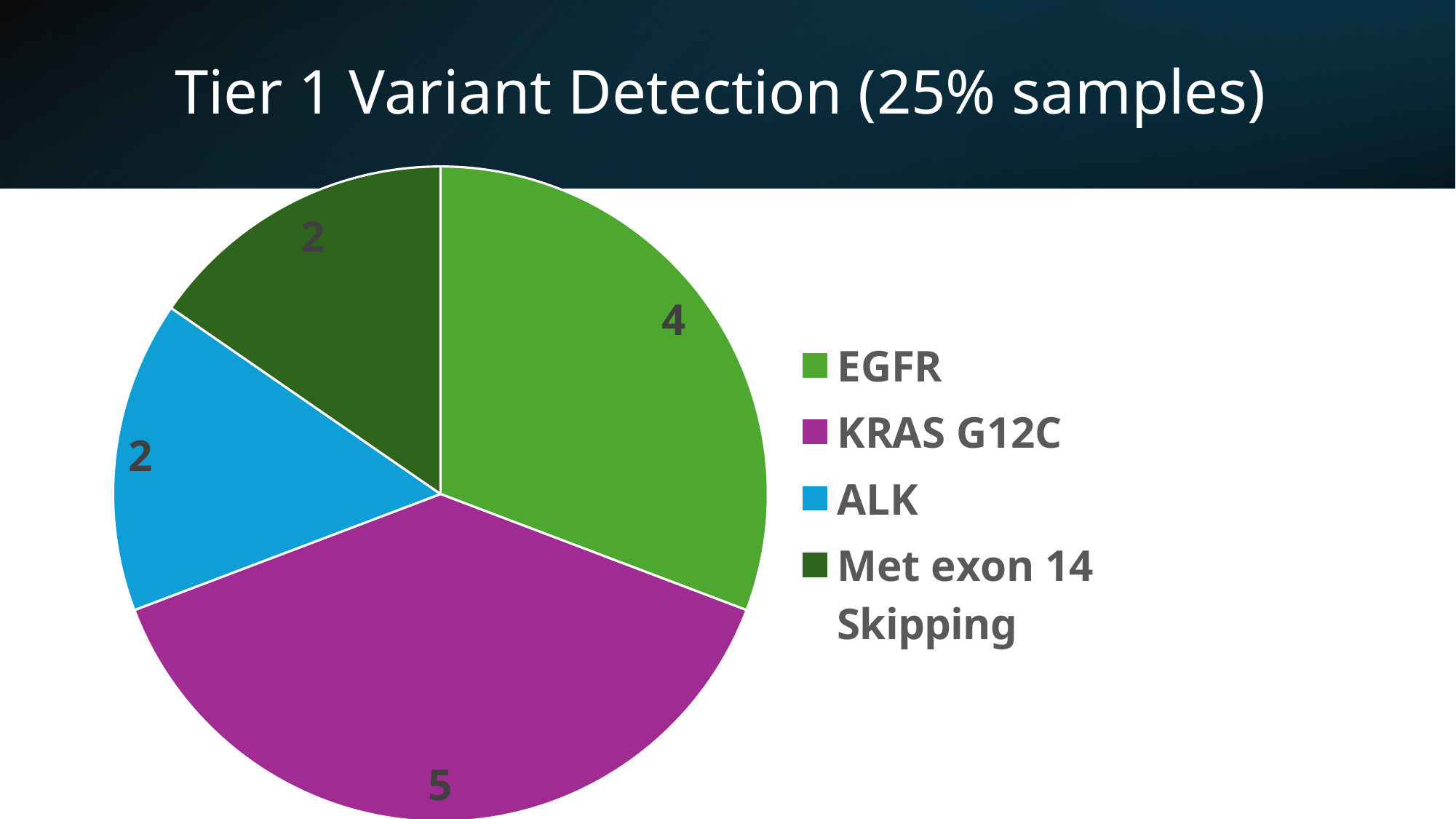
Which is larger, the value for EGFR or the value for ALK? EGFR What is the title of the chart? Tier 1 Variant Detection (25% samples) What is the value for KRAS G12C? 5 What colour is the KRAS G12C slice? purple What is the value for Met exon 14 Skipping? 2 What is the value for ALK? 2 What type of chart is shown on the slide? pie chart What is the value for EGFR? 4 What is the total of all slices in the pie chart? 13 Which category has the largest slice? KRAS G12C How many categories does the pie chart have? 4 What is the difference between the values for KRAS G12C and EGFR? 1